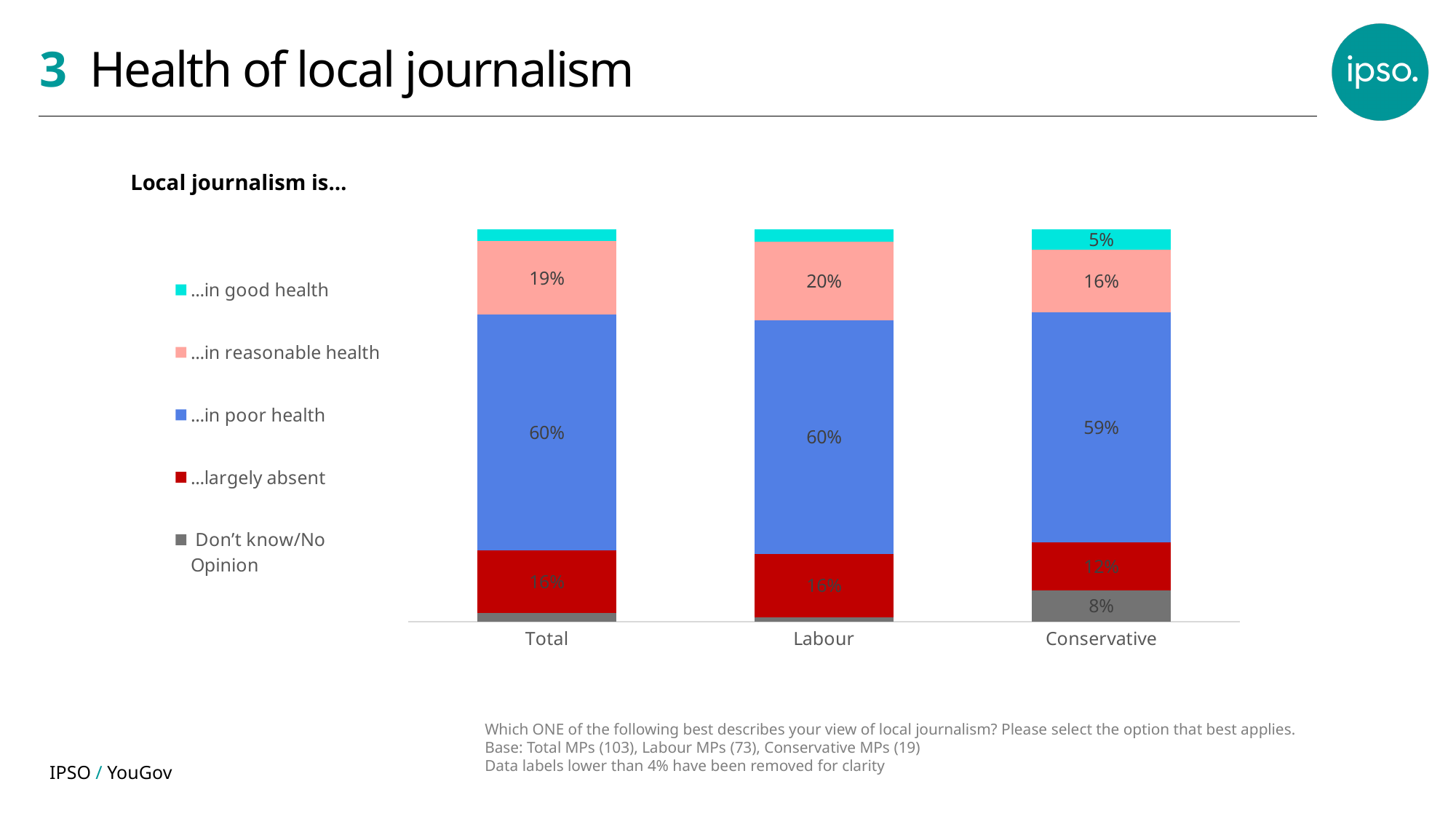
What percentage of Conservative MPs say local journalism is largely absent? 12% Which is larger: the share of Total MPs saying local journalism is largely absent, or the share of Conservative MPs saying so? Total What percentage of Conservative MPs say local journalism is in good health? 5% What percentage of Labour MPs say local journalism is in reasonable health? 20% Which group has the lowest share saying local journalism is in poor health? Conservative Which colour represents '...in poor health' in the legend? Blue What is the difference between the Labour and Conservative shares saying local journalism is in reasonable health? 4% How many groups (bars) are shown on the x axis? 3 What kind of chart is shown on the slide? Stacked bar chart What percentage of Total MPs say local journalism is in poor health? 60% How many series does the legend list? 5 What percentage of Conservative MPs answered Don't know/No Opinion? 8%